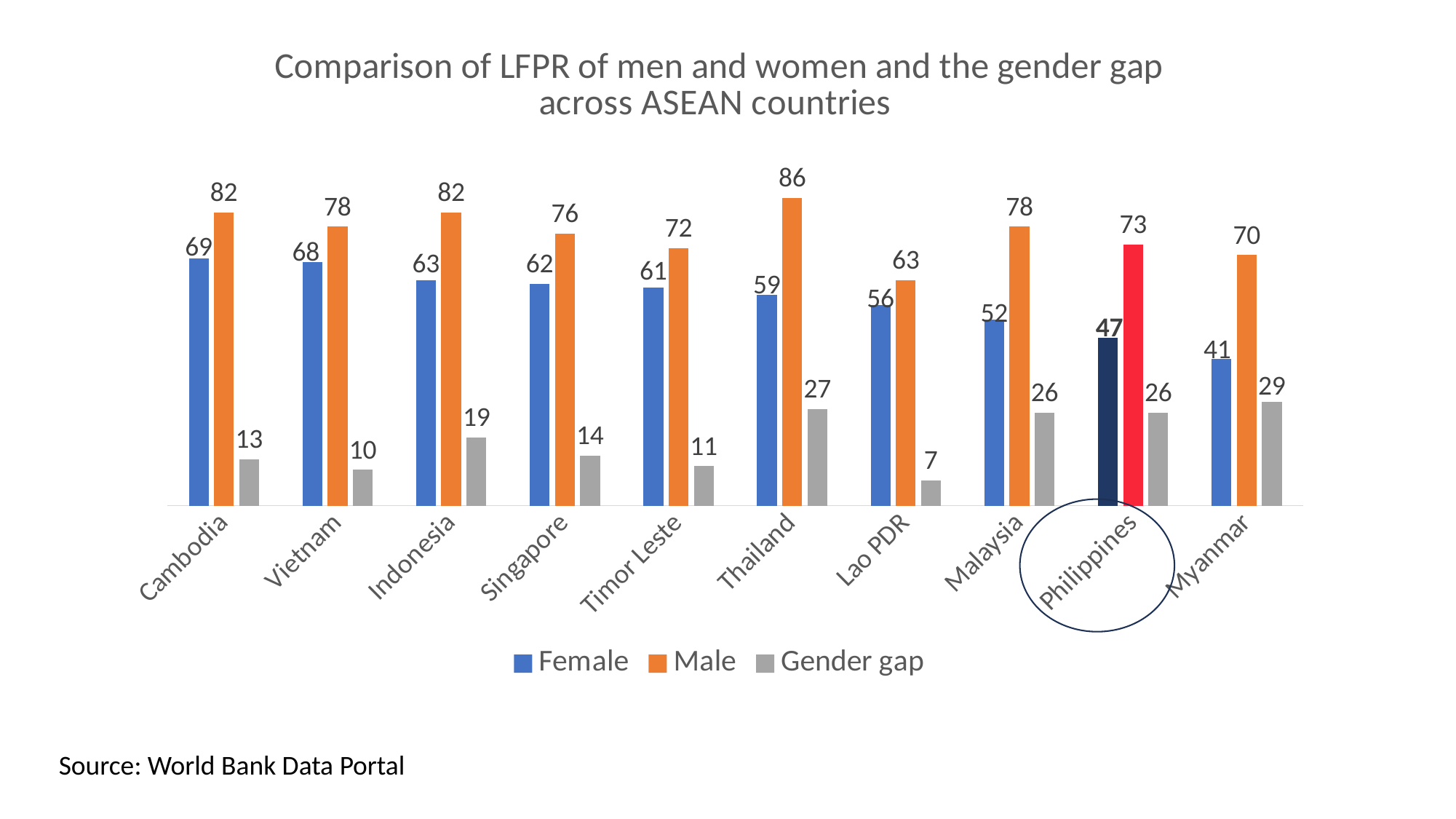
Which is larger, the Female value for Cambodia or the Female value for Vietnam? Cambodia Which country has the largest Gender gap value? Myanmar How many series does the legend list? 3 What kind of chart is shown on the slide? Bar chart Which country has the highest Male LFPR value? Thailand What is the difference between the Male and Female values for Indonesia? 19 Which country has the lowest Female LFPR value? Myanmar What is the Female LFPR value for the Philippines? 47 What is the Male LFPR value for Thailand? 86 What is the Gender gap value for Lao PDR? 7 Which country's label is circled on the chart? Philippines How many countries are shown on the x axis? 10